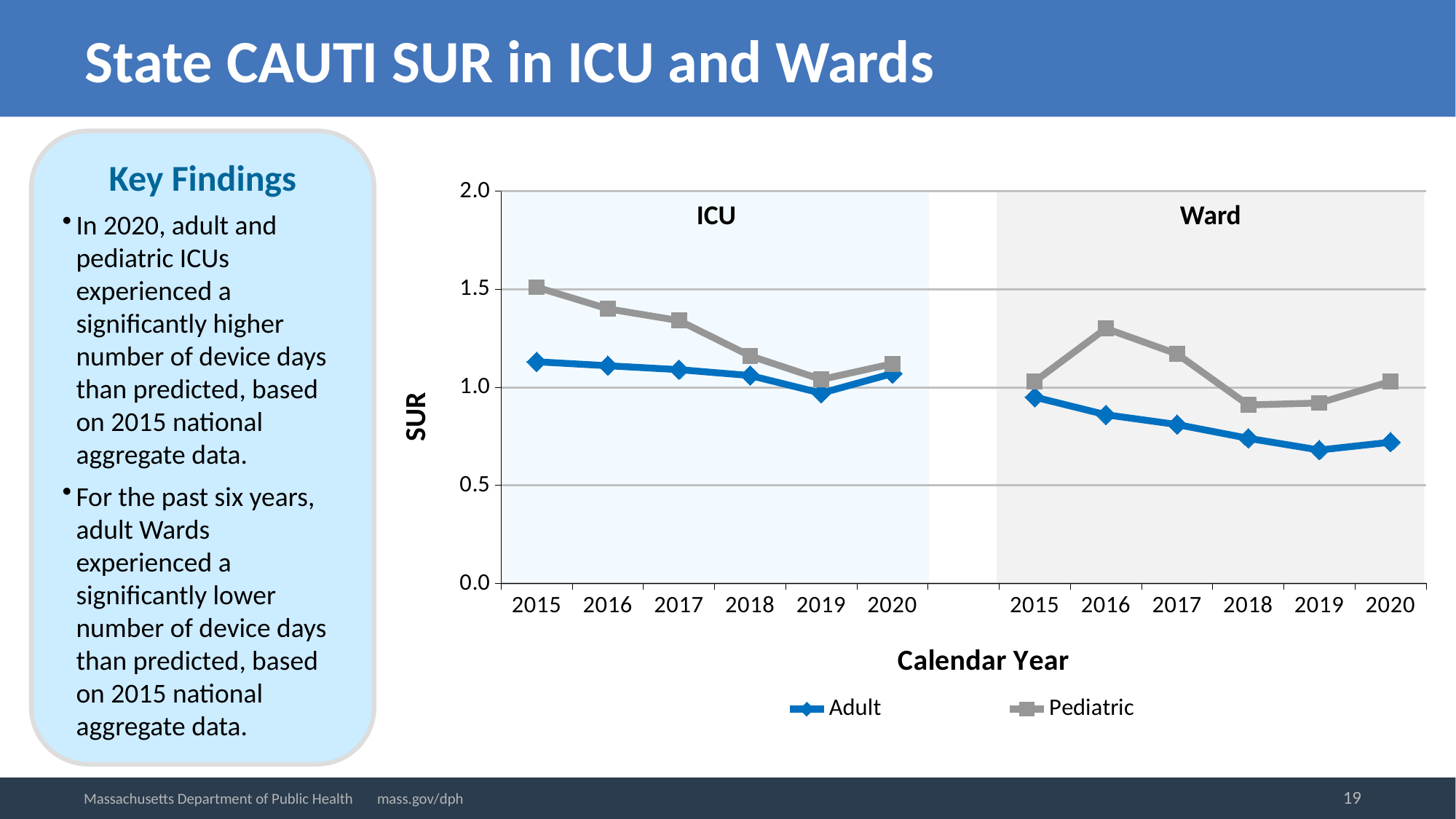
How many series does the chart legend list? 2 How many calendar years are plotted in the ICU panel of the chart? 6 What kind of chart is shown on the slide? line chart In the ICU panel, which year has the highest Pediatric SUR? 2015 In the Ward panel, is the Pediatric SUR for 2016 greater or less than 1.0? greater In the ICU panel, is the Pediatric SUR for 2016 greater or less than 1.5? less In the Ward panel, is the Adult SUR for 2019 greater or less than 1.0? less In the Ward panel, which year has the highest Pediatric SUR? 2016 In the ICU panel for 2015, which series has the higher SUR, Adult or Pediatric? Pediatric In the ICU panel, which year has the lowest Adult SUR? 2019 In the ICU panel, does the Pediatric SUR rise or fall from 2015 to 2019? fall What is the title of the x axis of the chart? Calendar Year